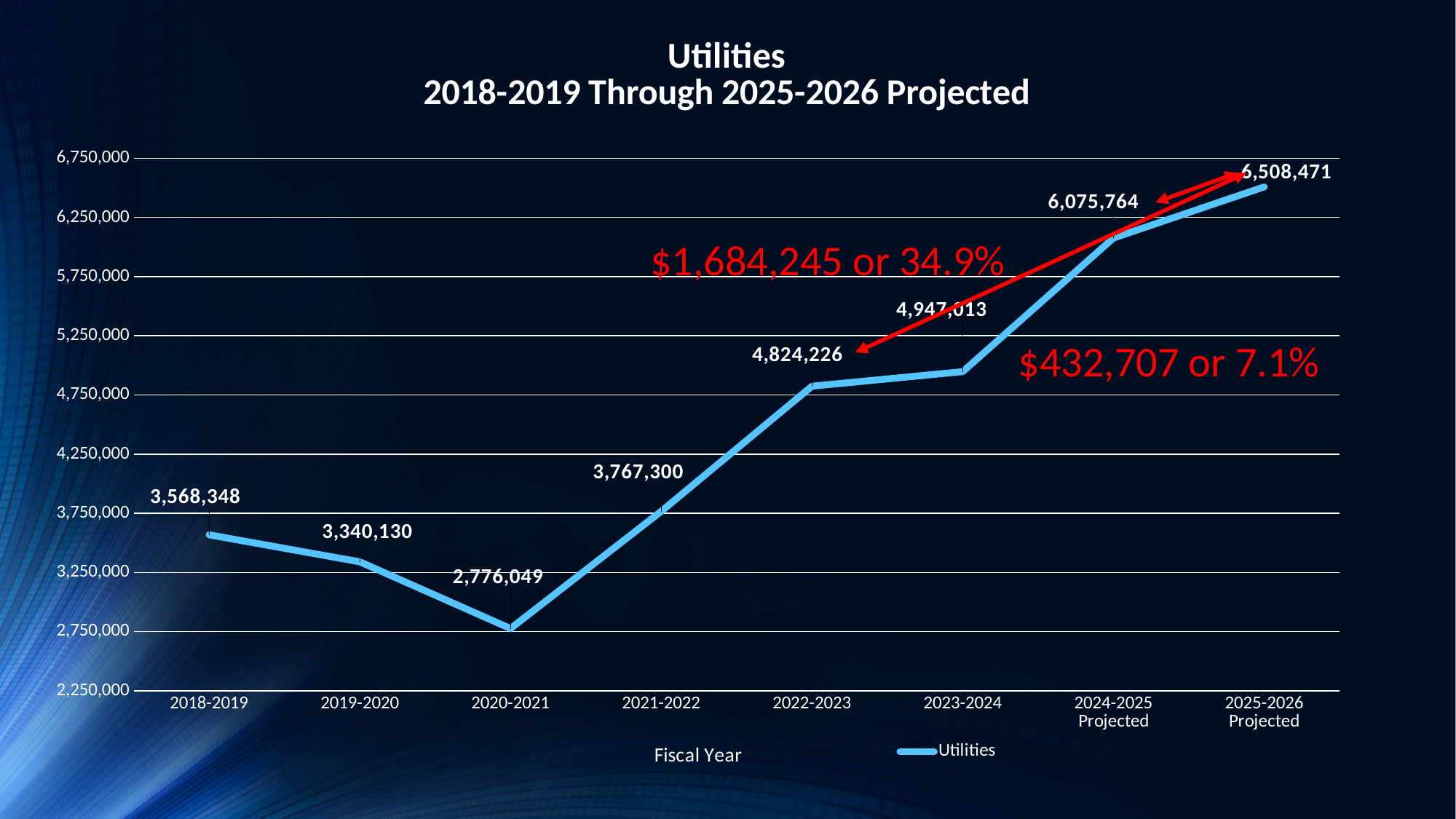
Which is larger, the Utilities value for 2019-2020 or for 2021-2022? 2021-2022 Which fiscal year has the lowest Utilities value? 2020-2021 What is the Utilities value for 2024-2025 Projected? 6,075,764 What type of chart is shown on the slide? Line chart How many fiscal years are plotted on the chart? 8 What is the Utilities value for 2020-2021? 2,776,049 What is the Utilities value for 2021-2022? 3,767,300 Which fiscal year has the highest Utilities value? 2025-2026 Projected What is the difference between the Utilities values for 2025-2026 Projected and 2024-2025 Projected? 432,707 Do the Utilities values rise or fall from 2020-2021 to 2025-2026 Projected? Rise What is the difference between the Utilities values for 2018-2019 and 2020-2021? 792,299 How many series does the legend list? 1